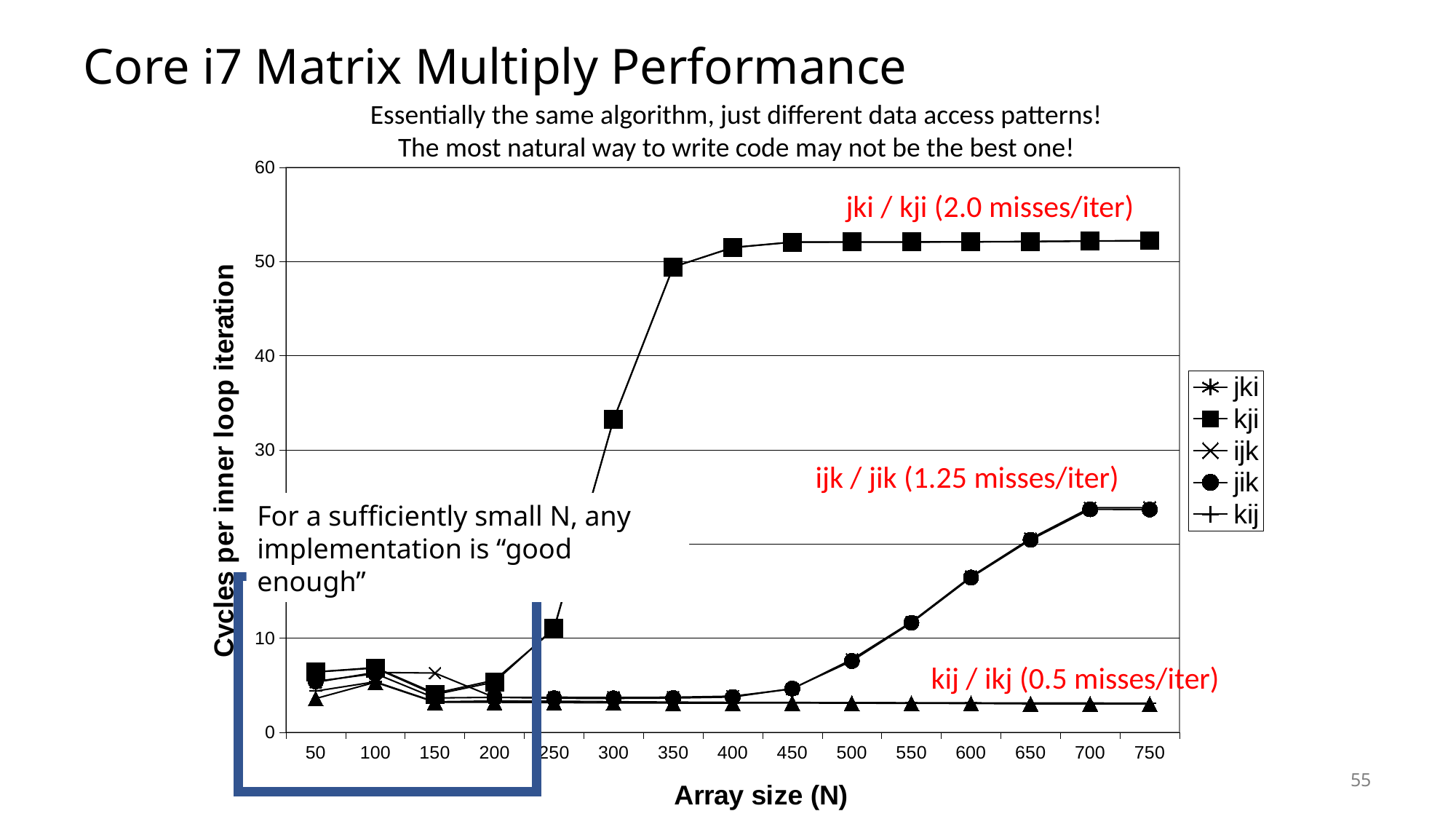
What kind of chart is shown on the slide? line chart Does the kji series rise or fall as the array size increases from 200 to 400? rise Is the value for kij at N = 750 greater or less than 10? less Is the value for kji at N = 300 greater or less than 30? greater How many array sizes (N) are plotted along the x axis? 15 Is the value for jik at N = 750 greater or less than 20? greater At N = 750, which is larger: the value for kji or the value for kij? kji How many series does the legend list? 5 What is the label of the x axis? Array size (N) Which series has the highest cycles per inner loop iteration at N = 750? kji